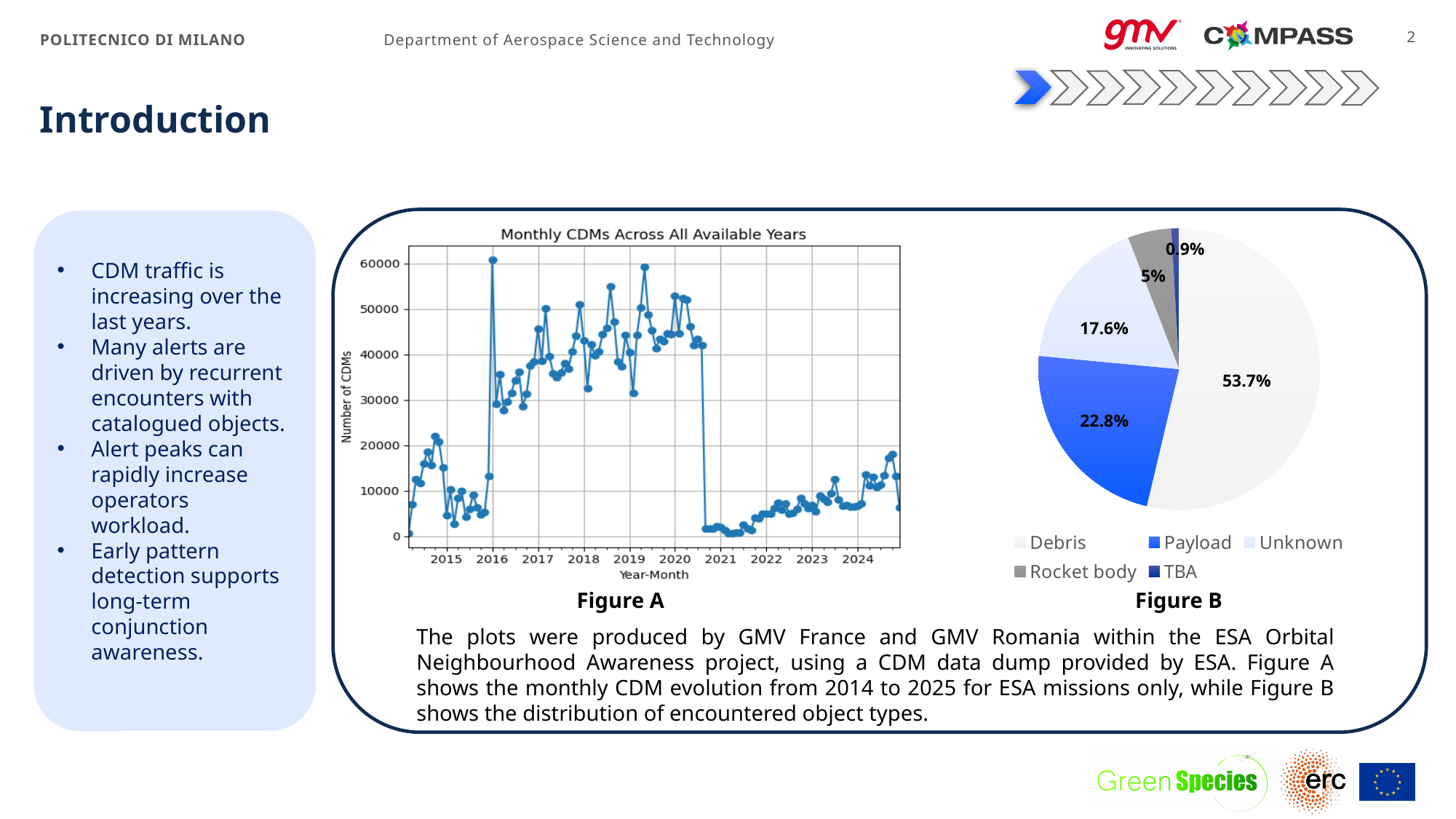
In Figure B, what share of the pie is Unknown? 17.6% In Figure B, what share of the pie is TBA? 0.9% In Figure B, how many percentage points larger is the Debris share than the Payload share? 30.9 percentage points In Figure B, how many categories does the legend list? 5 In Figure B, what share of the pie is Debris? 53.7% In Figure B, which object type has the largest slice? Debris In Figure B, which object type has the smallest slice? TBA What kind of chart is Figure B? pie chart What kind of chart is Figure A? line chart In Figure A, is the highest monthly value, reached around 2016, greater or less than 50000? greater